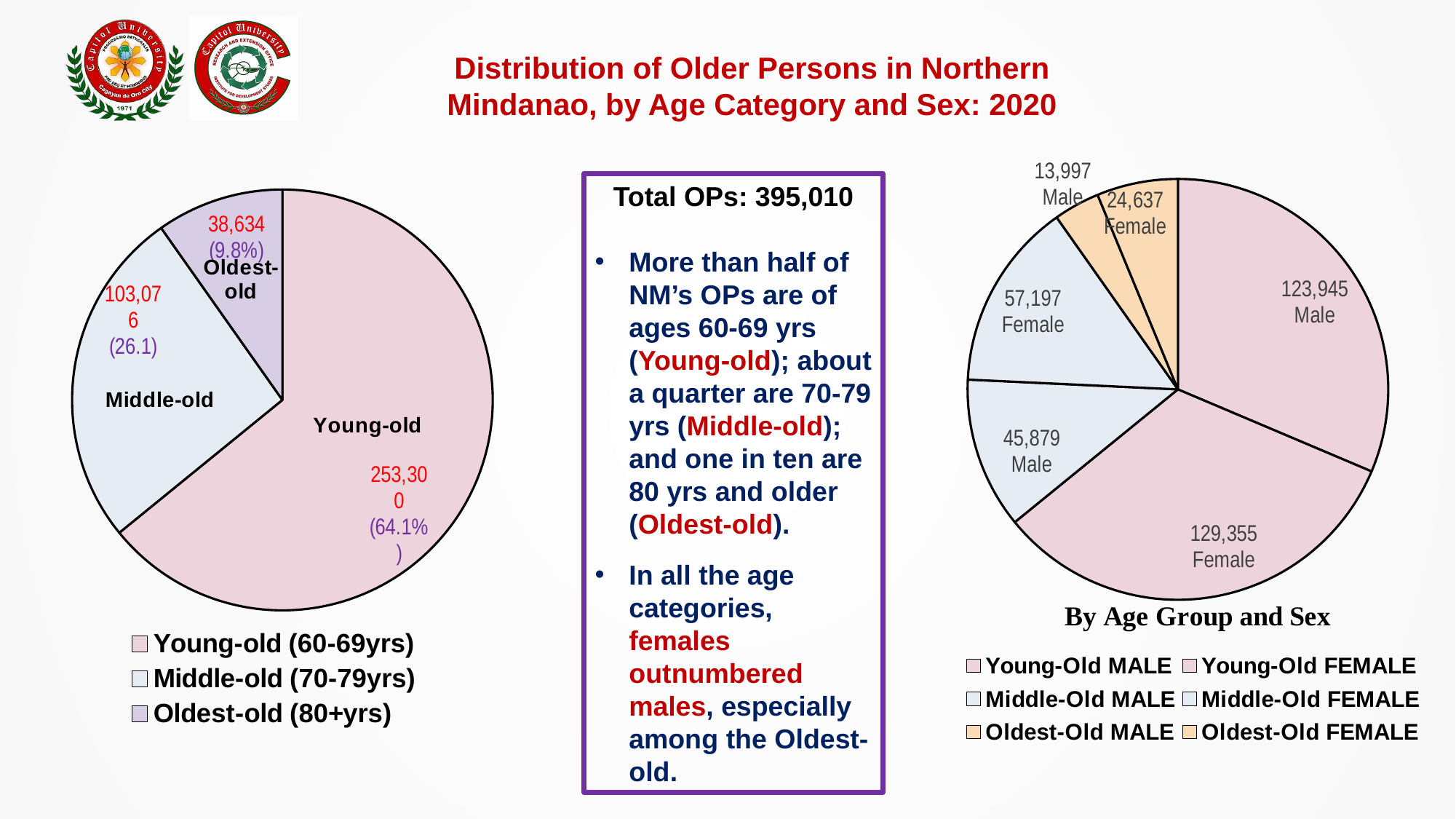
In the left pie chart, what is the difference between the Middle-old and Oldest-old values? 64,442 How many slices does the right pie chart titled 'By Age Group and Sex' have? 6 In the right pie chart titled 'By Age Group and Sex', what is the value for Middle-Old FEMALE? 57,197 In the right pie chart titled 'By Age Group and Sex', which is larger: Middle-Old MALE or Middle-Old FEMALE? Middle-Old FEMALE In the right pie chart titled 'By Age Group and Sex', which slice is the largest? Young-Old FEMALE In the right pie chart titled 'By Age Group and Sex', what is the value for Oldest-Old MALE? 13,997 In the left pie chart, which age category has the smallest slice? Oldest-old In the left pie chart, what is the value for Young-old? 253,300 What type of chart is the left chart on the slide? Pie chart In the left pie chart, what percentage share is shown for Oldest-old? 9.8% In the right pie chart titled 'By Age Group and Sex', what is the difference between Oldest-Old FEMALE and Oldest-Old MALE? 10,640 How many categories does the legend of the left pie chart list? 3